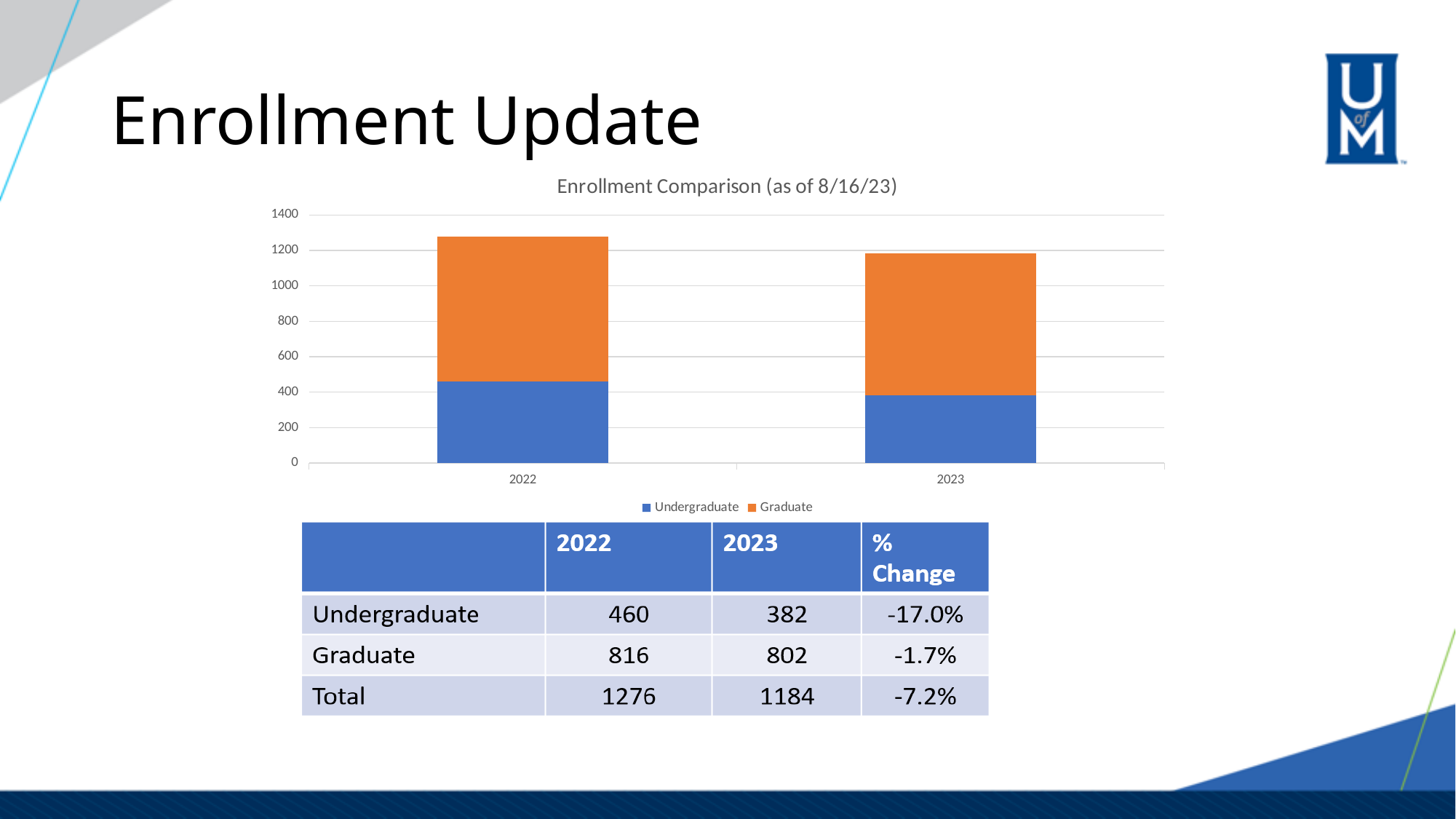
Is the total enrollment for 2023 greater or less than 1200? less Does total enrollment rise or fall from 2022 to 2023? Fall What is the Undergraduate enrollment for 2022? 460 What is the total enrollment for the 2022 stacked bar? 1276 What is the total enrollment for the 2023 stacked bar? 1184 What kind of chart is shown on the slide? Stacked bar chart How many series does the chart legend list? 2 What is the difference between Undergraduate enrollment in 2022 and 2023? 78 What is the title of the chart? Enrollment Comparison (as of 8/16/23) What is the Graduate enrollment for 2023? 802 Which year has the higher total enrollment, 2022 or 2023? 2022 How many years are shown on the x axis of the chart? 2